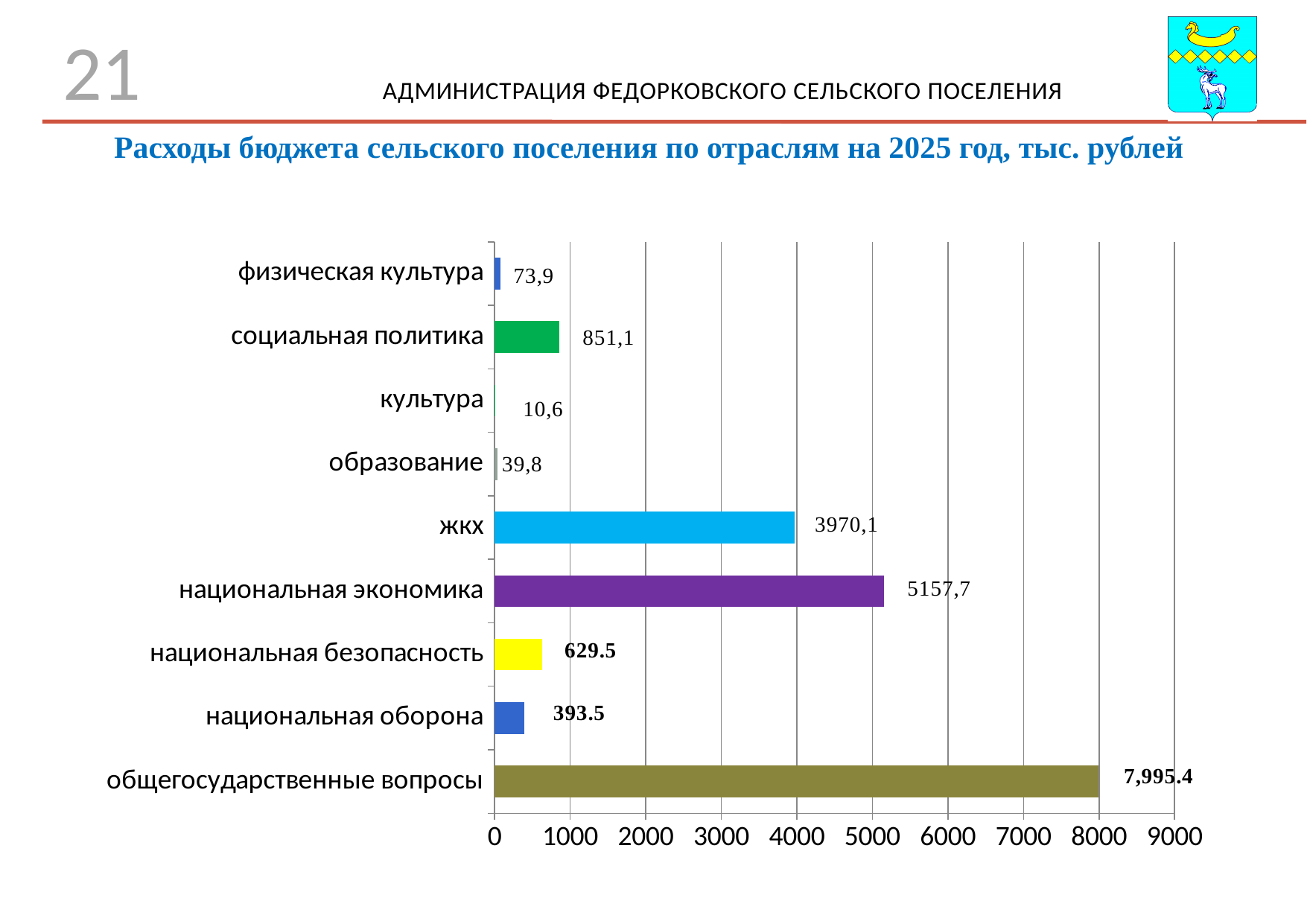
Which category has the lowest value? культура What kind of chart is shown on the slide? bar chart Which is larger, the value for социальная политика or the value for национальная безопасность? социальная политика What is the difference between the values for национальная экономика and жкх? 1187,6 How many categories are shown in the chart? 9 What is the value for национальная экономика? 5157,7 What is the title of the chart? Расходы бюджета сельского поселения по отраслям на 2025 год, тыс. рублей What is the value for социальная политика? 851,1 What is the value for жкх? 3970,1 What is the value for общегосударственные вопросы? 7,995.4 Is the value for жкх greater or less than 4000? less Which category has the highest value? общегосударственные вопросы